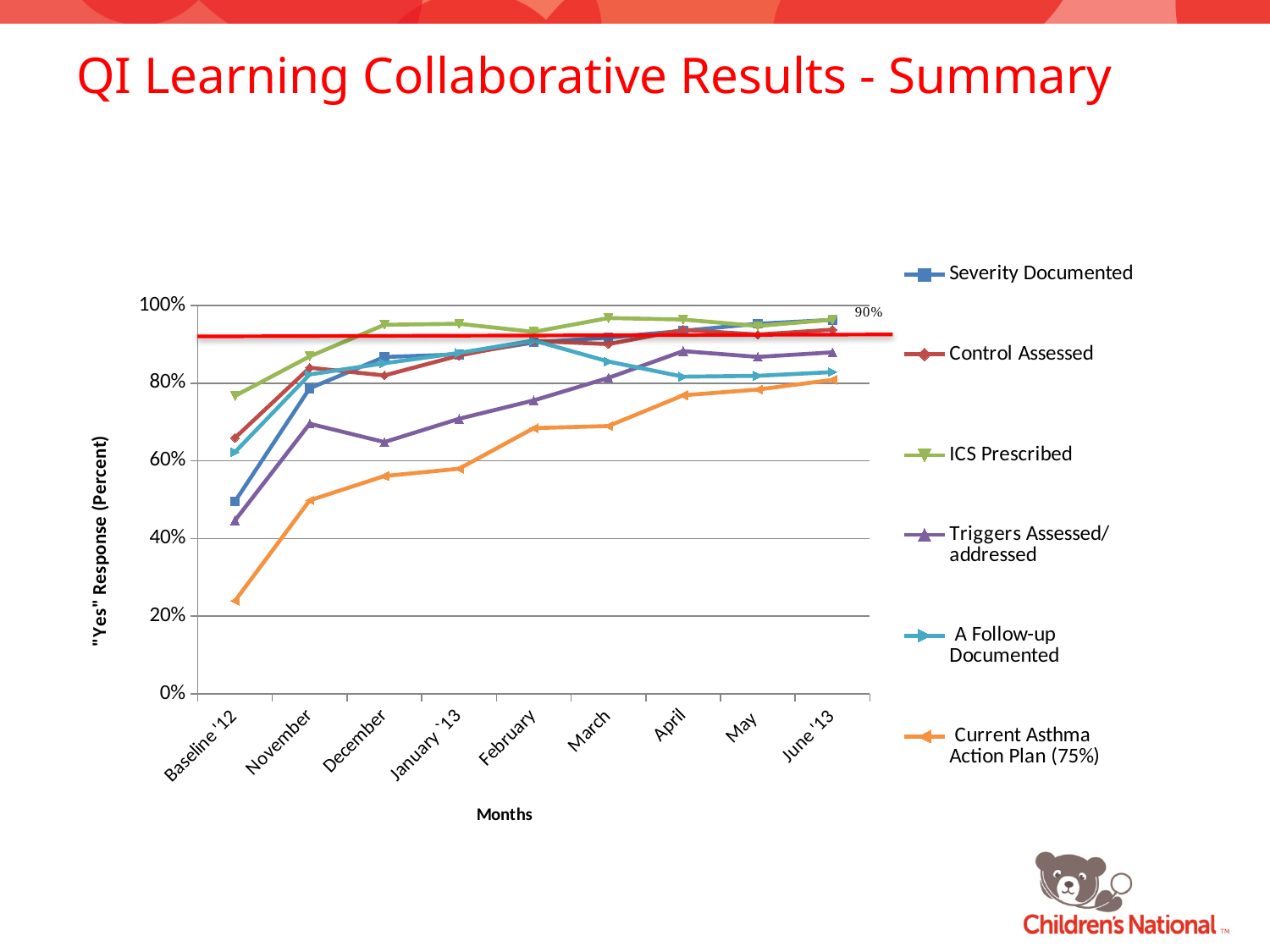
Which series has the lowest value at Baseline '12? Current Asthma Action Plan (75%) Does the Current Asthma Action Plan (75%) series rise or fall from Baseline '12 to June '13? rise Is the value for Current Asthma Action Plan (75%) at Baseline '12 greater or less than 40%? less How many series does the legend list? 6 Which series has the highest value at Baseline '12? ICS Prescribed What is the title of the y axis? "Yes" Response (Percent) Is the value for ICS Prescribed at Baseline '12 greater or less than 60%? greater At Baseline '12, which is larger: Control Assessed or Current Asthma Action Plan (75%)? Control Assessed How many months are plotted along the x axis? 9 What kind of chart is shown on the slide? line chart What value is labelled on the horizontal red reference line? 90% Is the value for Triggers Assessed/addressed in December greater or less than 80%? less